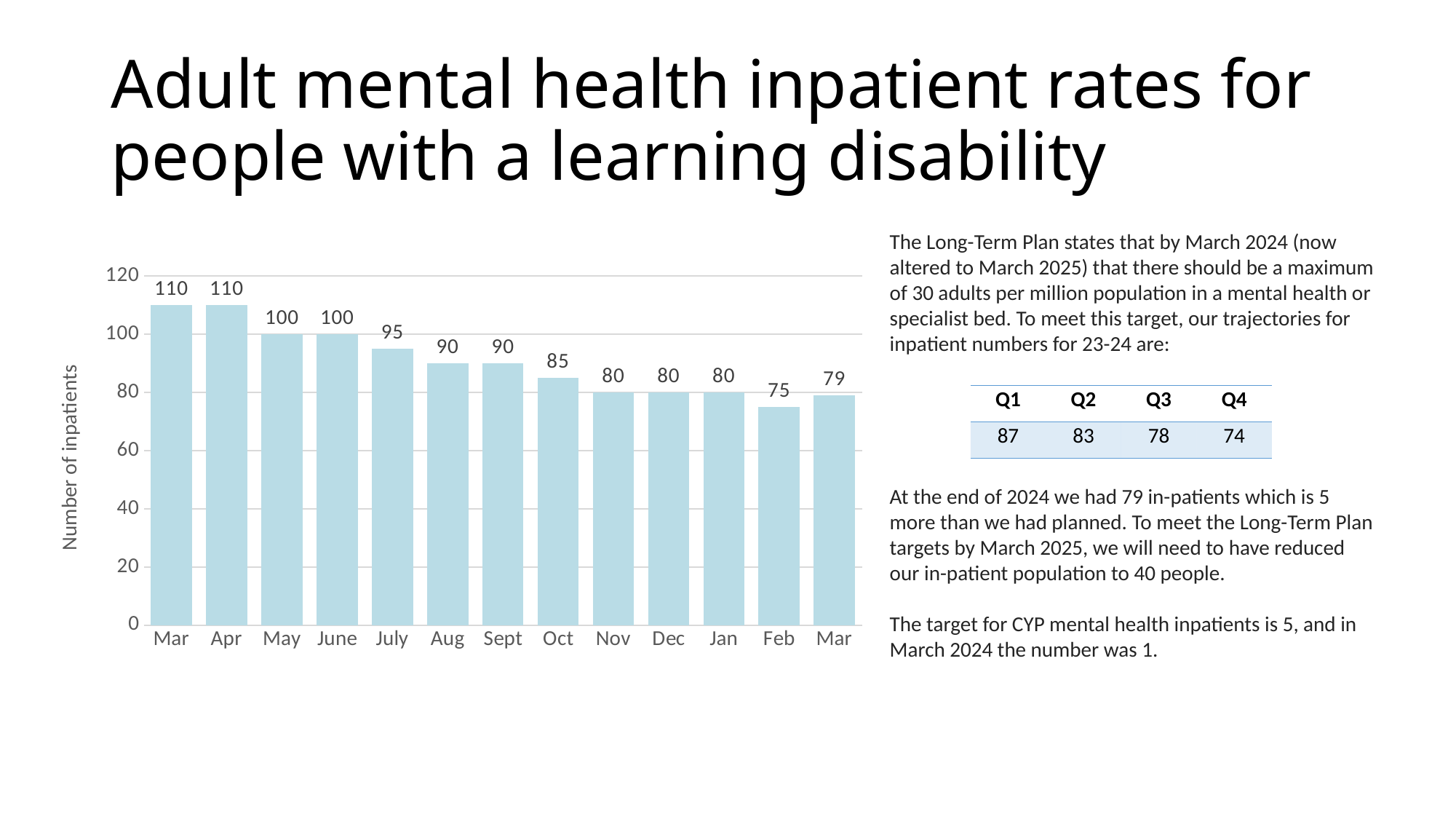
What is the number of inpatients for the last Mar bar on the right of the chart? 79 What is the number of inpatients for Feb? 75 How many bars are shown on the chart? 13 What kind of chart is shown on the slide? bar chart What is the difference between the number of inpatients in Apr and in Feb? 35 Which month has the lowest number of inpatients? Feb What is the number of inpatients for Oct? 85 Is the value for Nov greater or less than 100? less What is the highest value shown on the chart? 110 Do the values generally rise or fall from left to right along the x axis? fall Which is larger, the value for Aug or the value for Oct? Aug What is the number of inpatients for July? 95